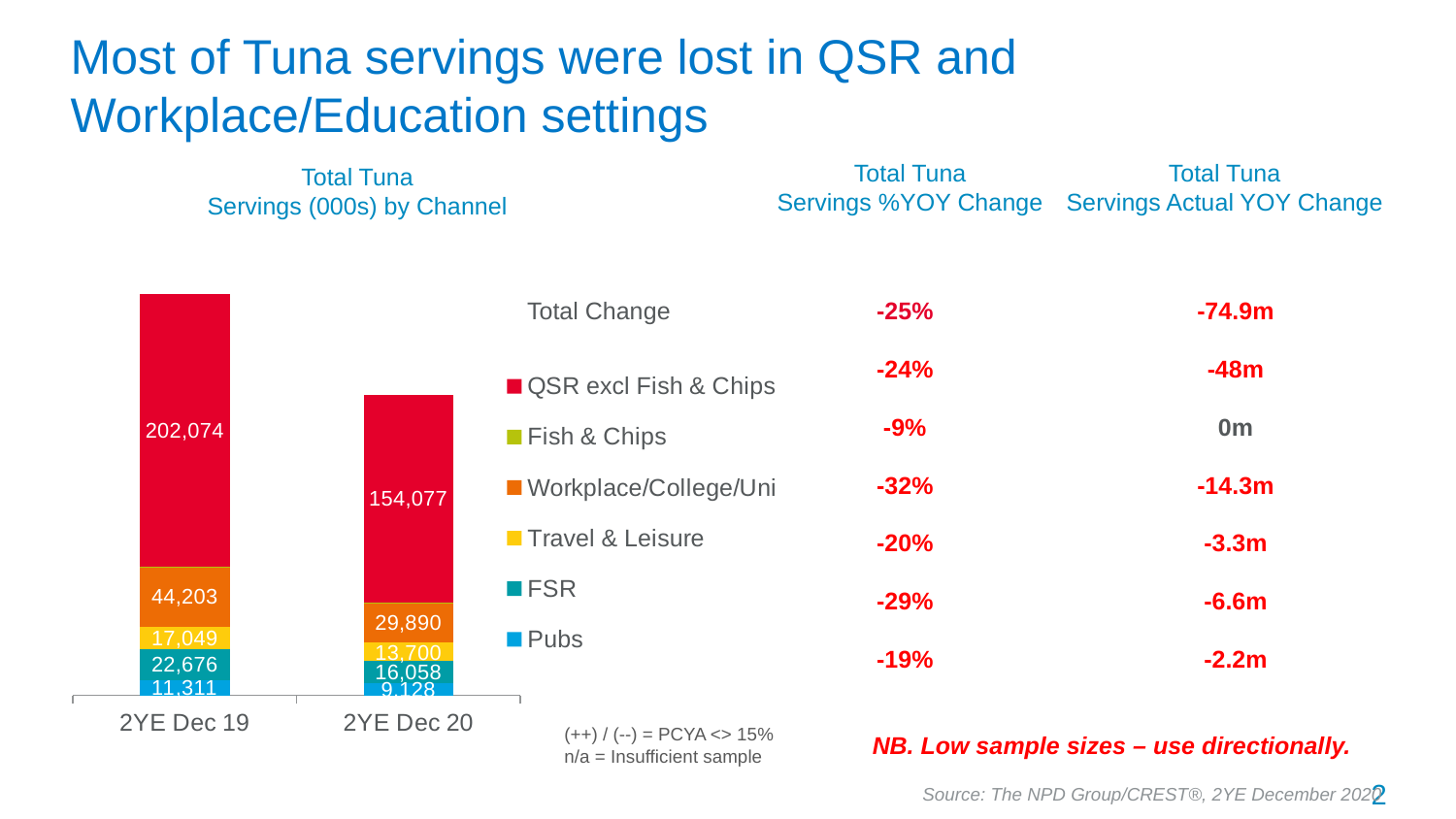
Which is larger: the Workplace/College/Uni segment in 2YE Dec 19 or in 2YE Dec 20? 2YE Dec 19 What is the value of the Pubs segment for 2YE Dec 20? 9,128 By how much did the QSR excl Fish & Chips segment fall from 2YE Dec 19 to 2YE Dec 20? 47,997 What is the value of the FSR segment for 2YE Dec 19? 22,676 Do total tuna servings rise or fall from 2YE Dec 19 to 2YE Dec 20? fall What is the value of the Workplace/College/Uni segment for 2YE Dec 20? 29,890 Which segment is the largest in the 2YE Dec 20 bar? QSR excl Fish & Chips What type of chart is shown on the slide? stacked bar chart How many series does the chart legend list? 6 What is the value of the QSR excl Fish & Chips segment for 2YE Dec 20? 154,077 What is the value of the QSR excl Fish & Chips segment for 2YE Dec 19? 202,074 How many bars (time periods) are plotted on the x axis? 2